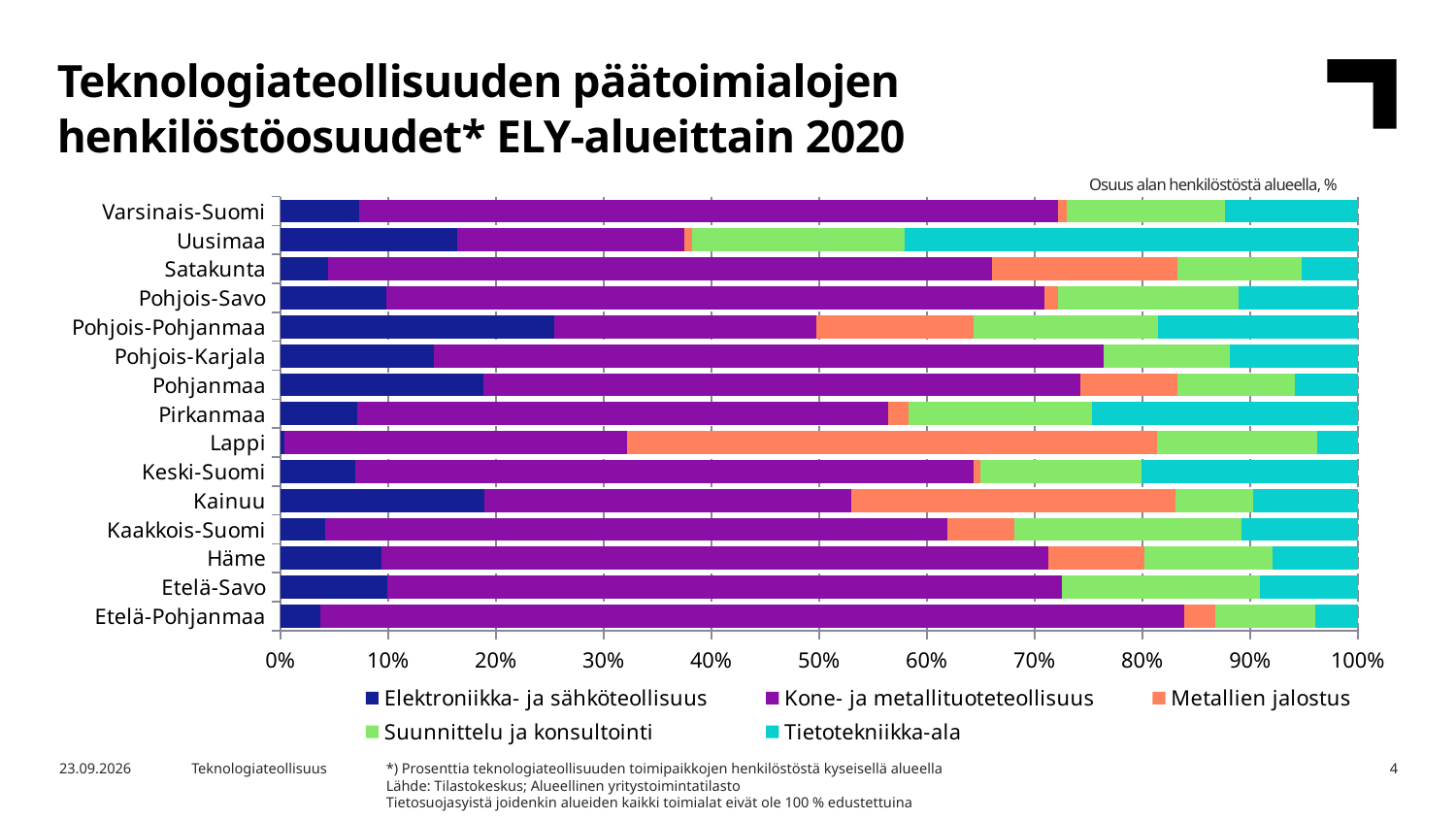
How many series does the chart legend list? 5 What is the title of the chart on the slide? Teknologiateollisuuden päätoimialojen henkilöstöosuudet* ELY-alueittain 2020 What kind of chart is shown on the slide? Stacked bar chart Is the Kone- ja metallituoteteollisuus share for Etelä-Pohjanmaa greater or less than 70%? greater Which region has the largest share for Elektroniikka- ja sähköteollisuus? Pohjois-Pohjanmaa Is the Tietotekniikka-ala share for Uusimaa greater or less than 30%? greater Which region has the larger Elektroniikka- ja sähköteollisuus share, Uusimaa or Satakunta? Uusimaa How many ELY regions are listed on the vertical axis of the chart? 15 Which region has the larger Kone- ja metallituoteteollisuus share, Lappi or Etelä-Pohjanmaa? Etelä-Pohjanmaa Which region has the largest share for Metallien jalostus? Lappi Is the Metallien jalostus share for Lappi greater or less than 40%? greater Which region has the largest share for Tietotekniikka-ala? Uusimaa